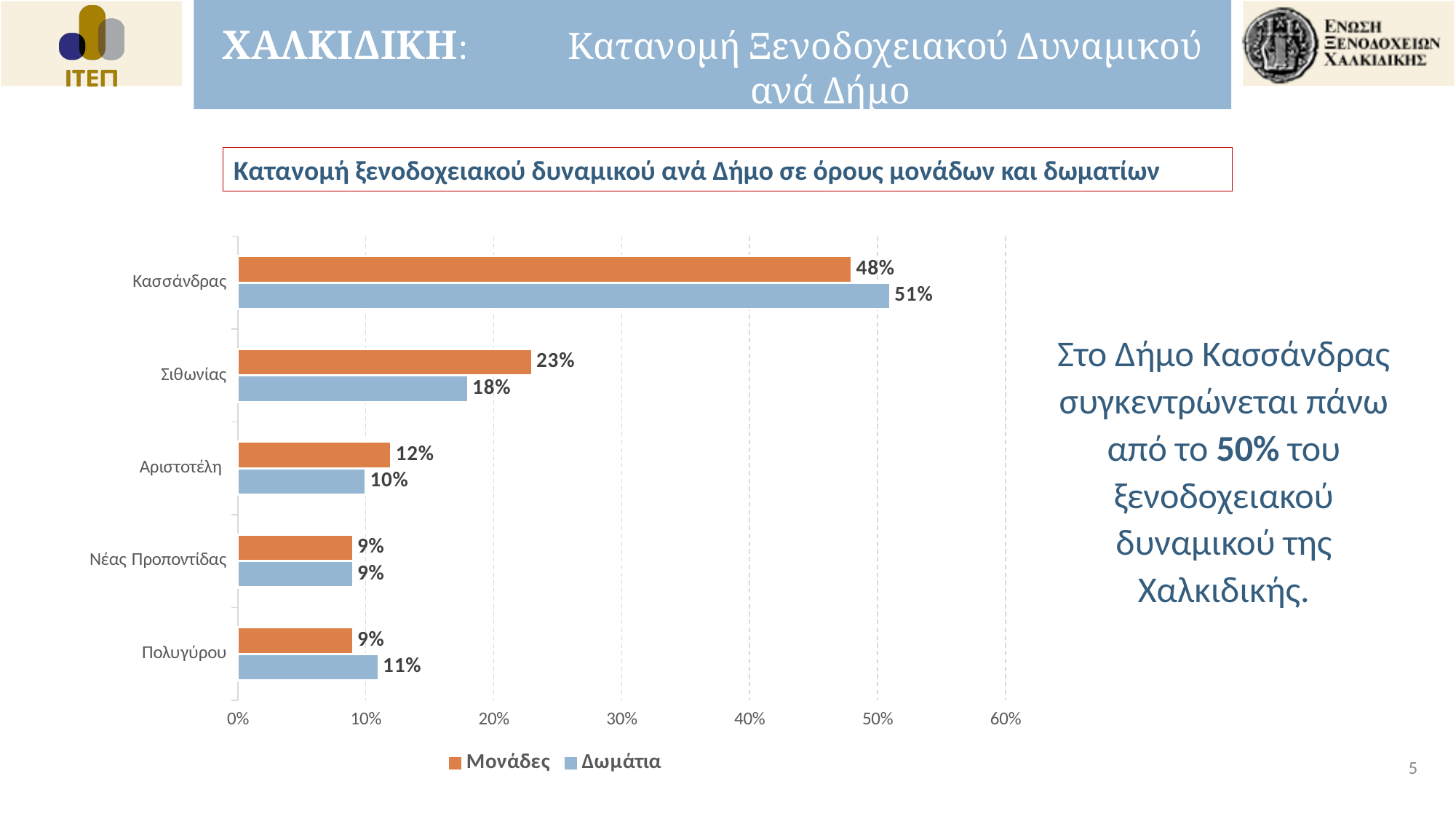
How many series does the legend list? 2 How many municipalities are shown on the chart? 5 What is the difference between the Μονάδες values for Σιθωνίας and Αριστοτέλη? 11% What is the Δωμάτια value for Πολυγύρου? 11% What is the Δωμάτια value for Σιθωνίας? 18% What is the Μονάδες value for Κασσάνδρας? 48% What is the difference between the Δωμάτια and Μονάδες values for Κασσάνδρας? 3% Which is larger for Σιθωνίας, the Μονάδες value or the Δωμάτια value? Μονάδες Which municipality has the lowest Δωμάτια value? Νέας Προποντίδας Which municipality has the highest Δωμάτια value? Κασσάνδρας What kind of chart is shown on the slide? Bar chart Is the Δωμάτια value for Κασσάνδρας greater or less than 50%? greater